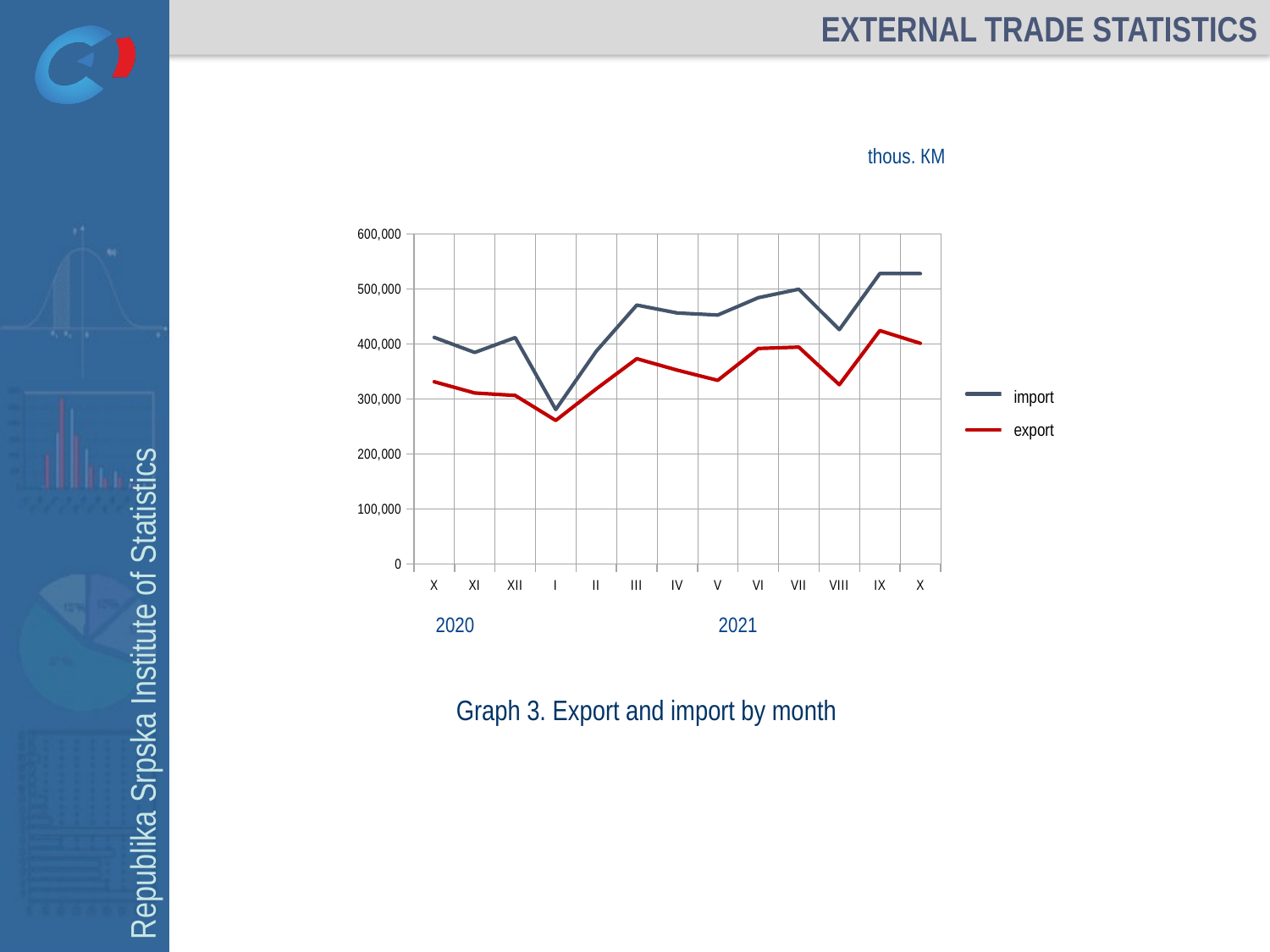
Is the export value for VIII 2021 greater or less than 400,000? less In which month is the export line at its lowest? I 2021 How many series does the legend list? 2 In which month is the import line at its lowest? I 2021 What kind of chart is shown on the slide? line chart Is the import value for IX 2021 greater or less than 500,000? greater How many months are plotted along the x axis? 13 Is the import value for I 2021 greater or less than 300,000? less Do both lines rise or fall from I 2021 to III 2021? rise What unit is stated above the chart? thous. KM In which month does the export line reach its highest value? IX 2021 Which series is higher in every month, import or export? import